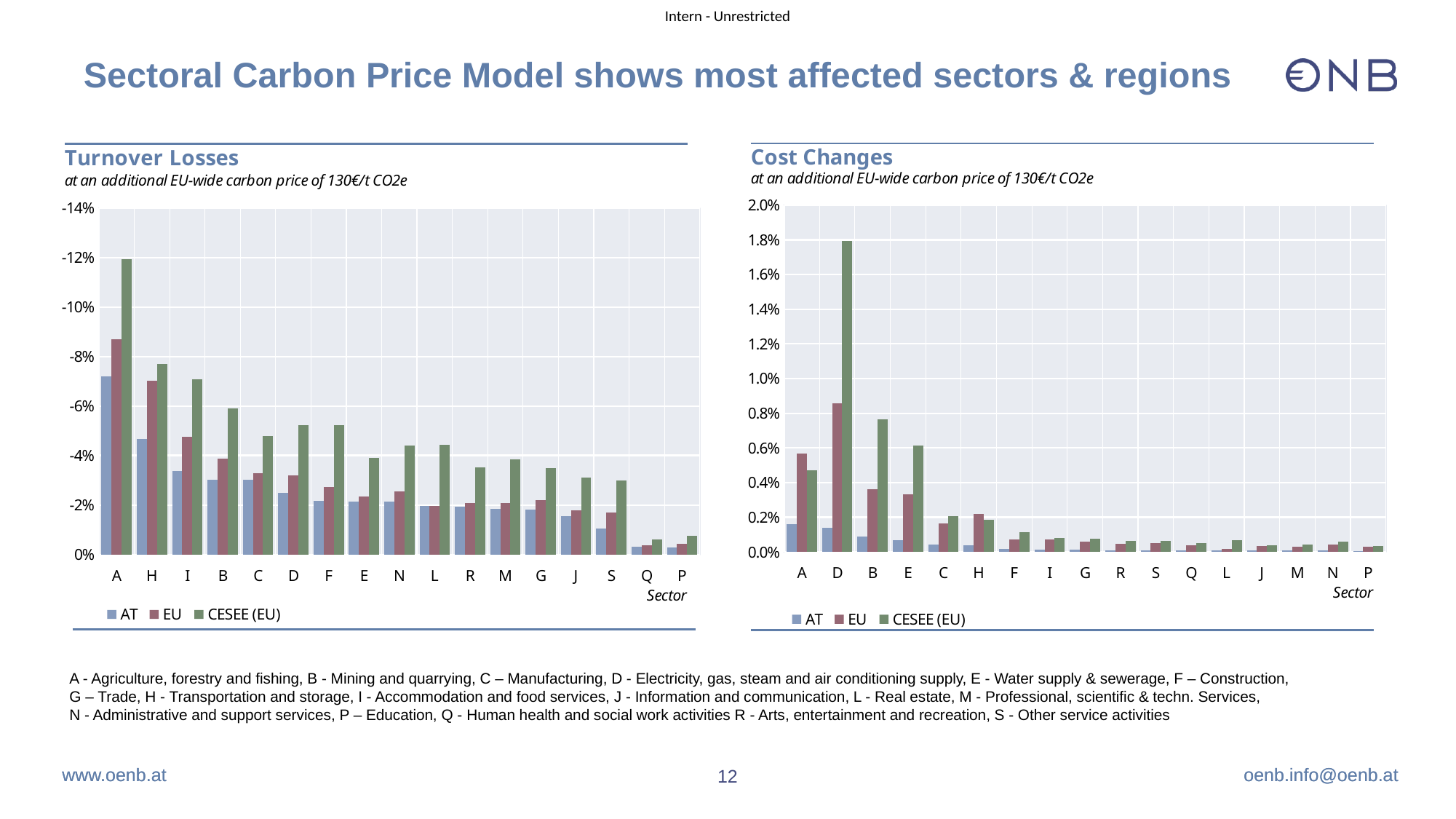
In the Cost Changes chart, which sector has the highest CESEE (EU) value? D How many series does the legend of the Cost Changes chart list? 3 In the Turnover Losses chart, do the CESEE (EU) turnover losses generally get larger or smaller in magnitude moving from left to right along the x axis? smaller In the Turnover Losses chart, which sector has the largest CESEE (EU) turnover loss? A In the Turnover Losses chart, for sector A, which series shows the larger turnover loss: AT or EU? EU In the Cost Changes chart, is the CESEE (EU) value for sector A greater or less than 0.6%? less In the Cost Changes chart, for sector D, which series has the larger value: EU or CESEE (EU)? CESEE (EU) How many sectors are shown on the x axis of the Cost Changes chart? 17 How many sectors are shown on the x axis of the Turnover Losses chart? 17 In the Cost Changes chart, is the AT value for sector A greater or less than 0.2%? less In the Cost Changes chart, is the CESEE (EU) value for sector D greater or less than 1.6%? greater What kind of chart is the Turnover Losses chart? bar chart